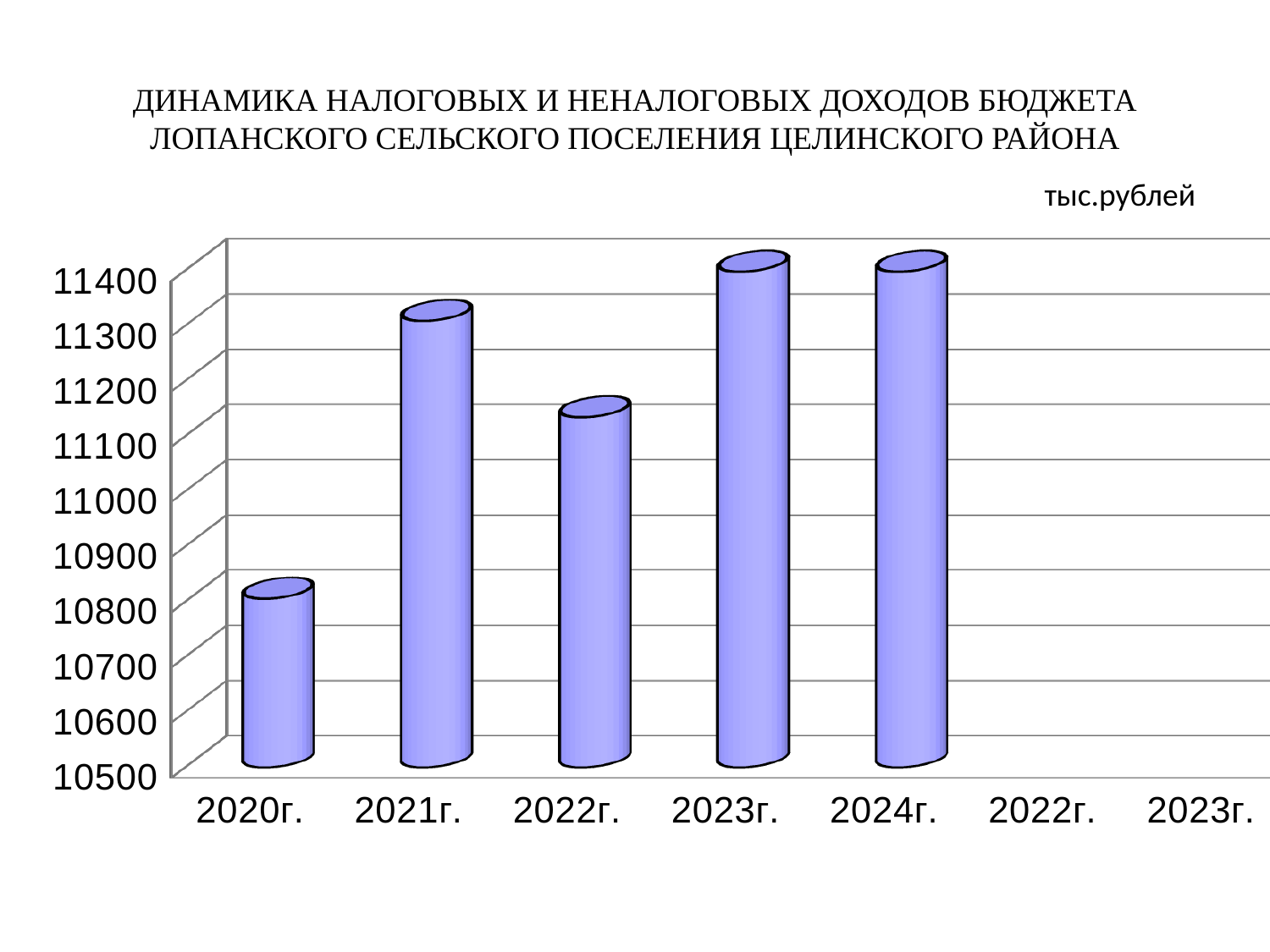
Does the value rise or fall from 2021г. to 2022г.? fall Is the value for 2021г. greater or less than 11200? greater What kind of chart is shown on the slide? bar chart How many bars are plotted on the chart? 5 Is the value for 2020г. greater or less than 11000? less Which year has the lowest value on the chart? 2020г. What unit of measurement is indicated above the chart? тыс.рублей Is the value for 2022г. greater or less than 11000? greater Which is larger, the value for 2020г. or the value for 2022г.? 2022г. Which is larger, the value for 2021г. or the value for 2022г.? 2021г.